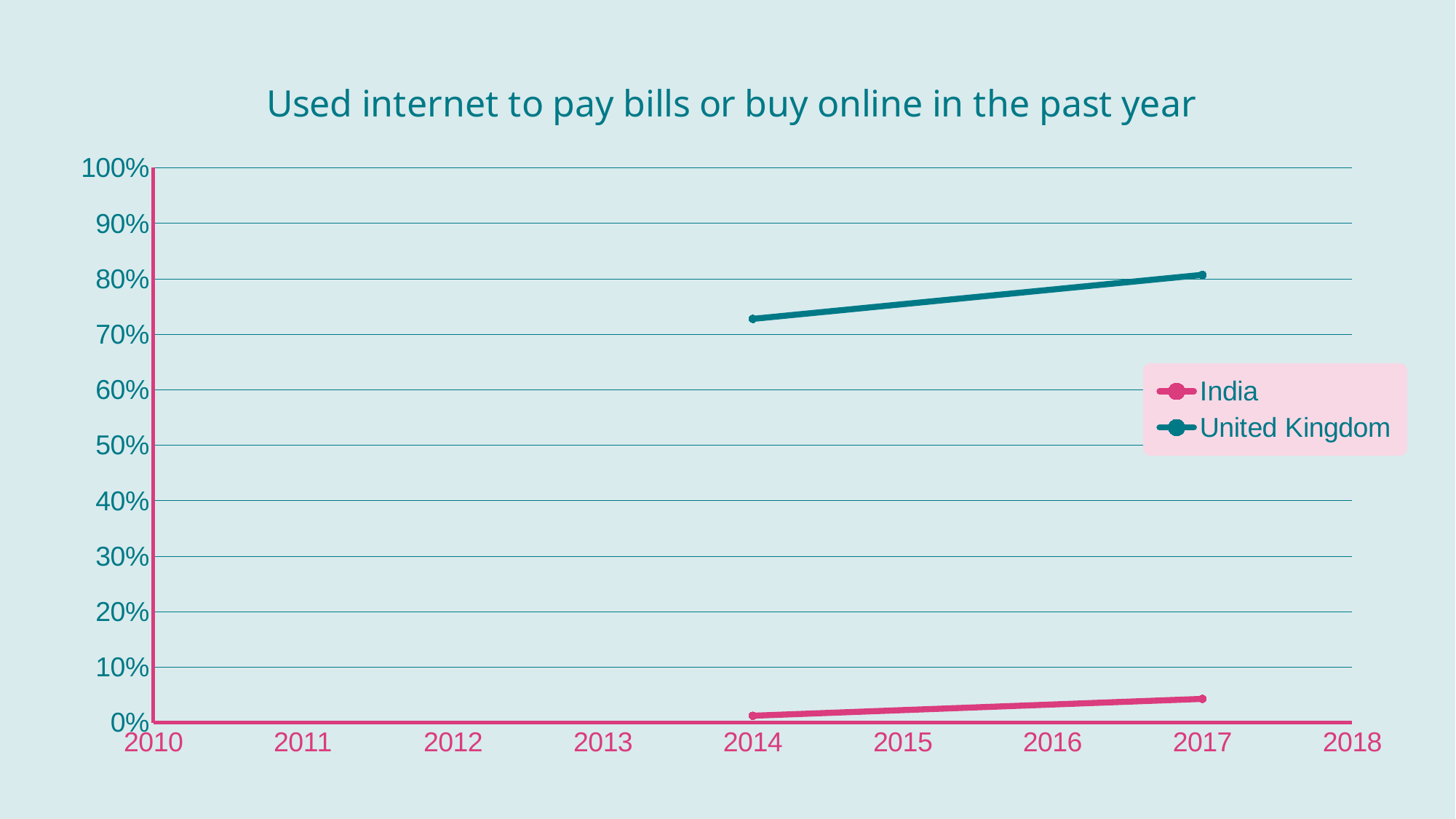
Is the value for United Kingdom in 2014 greater or less than 70%? greater How many series does the legend list? 2 Which series has the lower value in 2014? India What kind of chart is shown on the slide? line chart What is the title of the chart? Used internet to pay bills or buy online in the past year Is the value for India in 2017 greater or less than 10%? less Is the value for United Kingdom in 2017 greater or less than 90%? less Which series is drawn in pink? India How many data points are plotted for the India series? 2 Which series has the higher value in 2017, India or United Kingdom? United Kingdom Does the United Kingdom line rise or fall from 2014 to 2017? rise